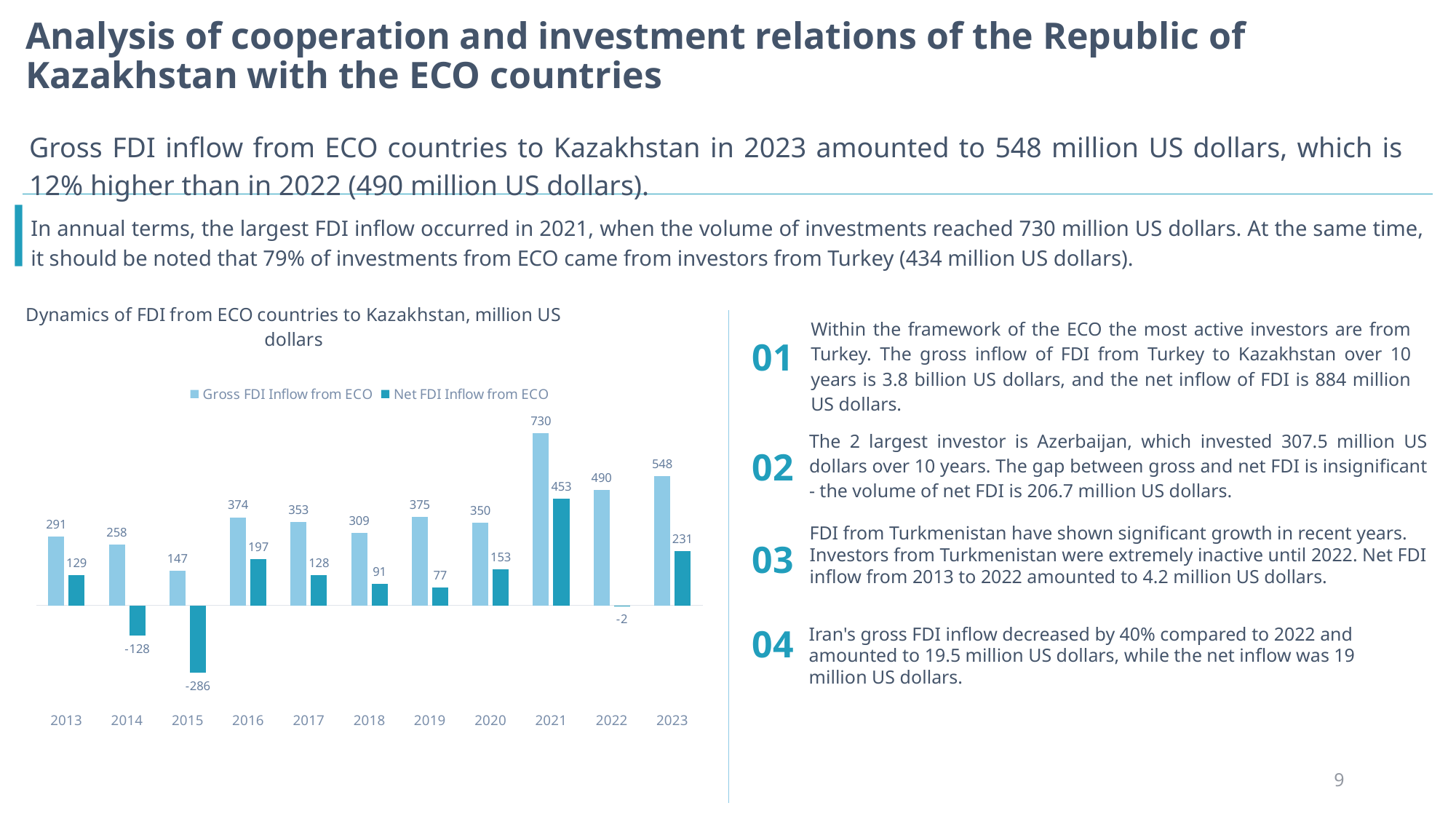
How many series does the chart legend list? 2 What is the title of the chart? Dynamics of FDI from ECO countries to Kazakhstan, million US dollars How many years are shown on the x axis of the chart? 11 What is the difference between the Gross FDI Inflow from ECO in 2023 and in 2022? 58 What kind of chart is shown on the slide? Bar chart Which is larger, the Net FDI Inflow from ECO in 2016 or in 2020? 2016 Which year has the lowest Net FDI Inflow from ECO? 2015 Does the Gross FDI Inflow from ECO rise or fall from 2021 to 2022? Fall Which year has the highest Gross FDI Inflow from ECO? 2021 What is the Net FDI Inflow from ECO in 2022? -2 What is the Gross FDI Inflow from ECO in 2021? 730 What is the Net FDI Inflow from ECO in 2015? -286